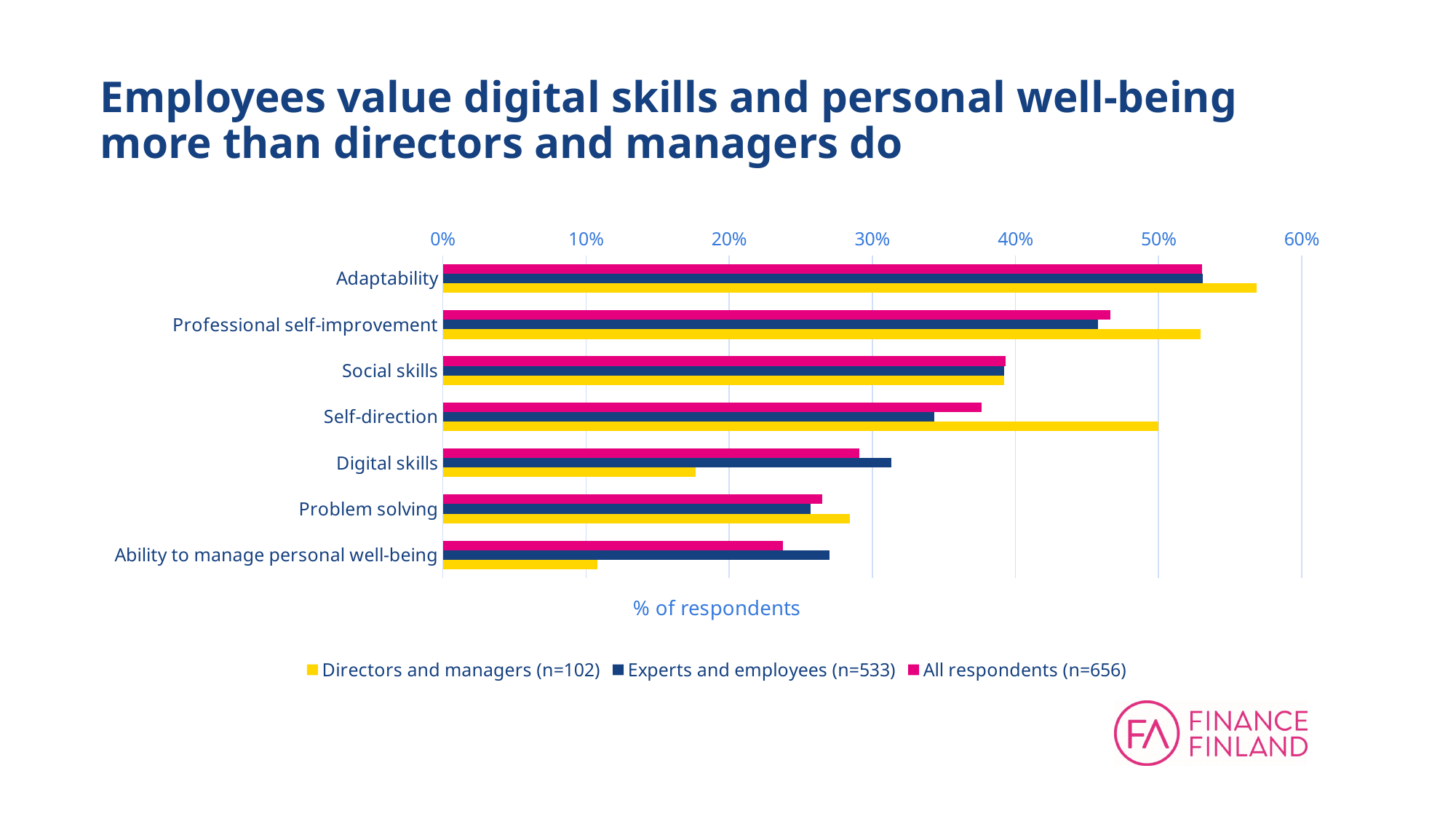
Is the value for Ability to manage personal well-being among Directors and managers greater or less than 20%? less How many skill categories are plotted on the chart? 7 What is the axis title shown below the chart? % of respondents Which category has the highest value for Directors and managers (n=102)? Adaptability Is the value for Self-direction among Directors and managers greater or less than 40%? greater Which category has the lowest value for Directors and managers (n=102)? Ability to manage personal well-being What kind of chart is shown on the slide? bar chart Which category has the highest value for Experts and employees (n=533)? Adaptability How many series does the legend list? 3 For Digital skills, which is larger: the value for Directors and managers or the value for Experts and employees? Experts and employees For Self-direction, which is larger: the value for Directors and managers or the value for Experts and employees? Directors and managers Is the value for Adaptability among All respondents greater or less than 50%? greater